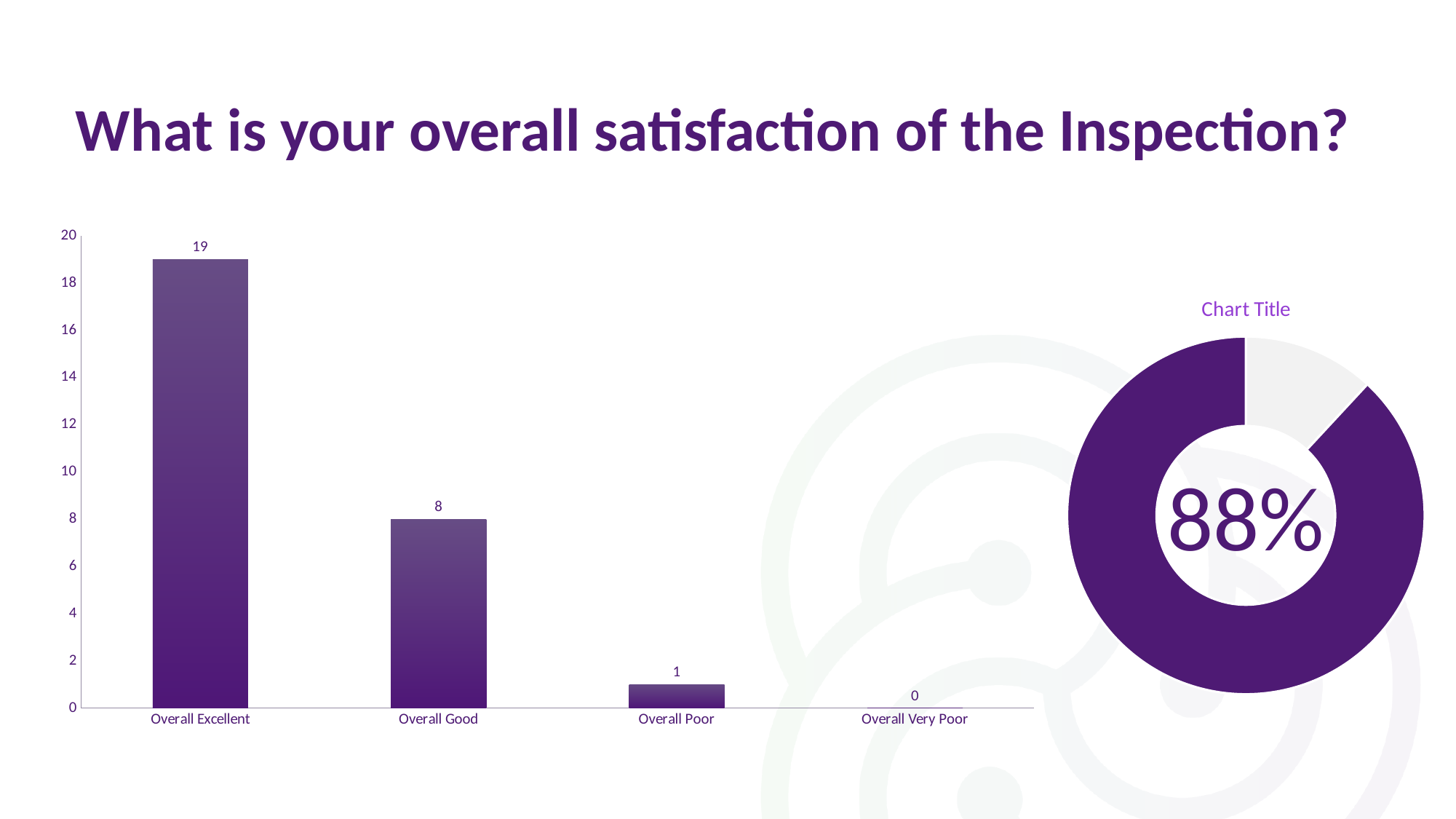
In the bar chart, which is larger, the value for Overall Good or the value for Overall Poor? Overall Good In the bar chart, what is the value for Overall Very Poor? 0 How many categories are shown in the bar chart? 4 In the bar chart, what is the value for Overall Excellent? 19 In the bar chart, what is the difference between the values for Overall Excellent and Overall Good? 11 In the bar chart, what is the value for Overall Poor? 1 In the bar chart, what is the value for Overall Good? 8 What kind of chart is the chart on the left of the slide? bar chart In the bar chart, which category has the highest value? Overall Excellent What is the title shown above the doughnut chart on the right? Chart Title In the bar chart, which category has the lowest value? Overall Very Poor What percentage is shown in the centre of the doughnut chart on the right? 88%